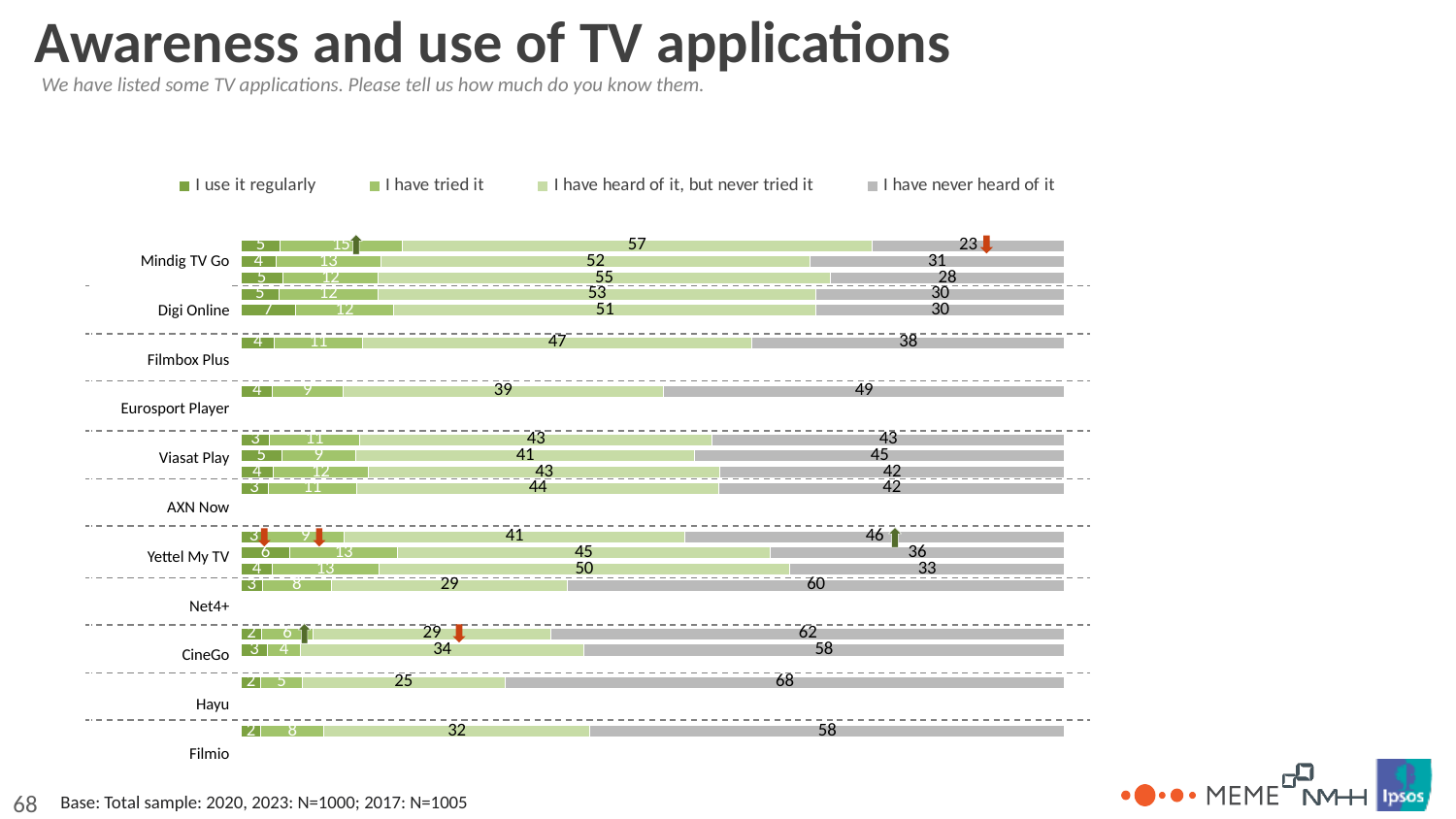
What is the value for 'I have never heard of it' for Hayu? 68 What kind of chart is shown on the slide? bar chart What is the value for 'I have heard of it, but never tried it' for Filmio? 32 What is the value for 'I have heard of it, but never tried it' for Filmbox Plus? 47 What is the value for 'I have never heard of it' for Eurosport Player? 49 Which has a larger 'I have never heard of it' value, Eurosport Player or Filmbox Plus? Eurosport Player What is the first entry in the chart's legend? I use it regularly Which TV application has the highest 'I have never heard of it' value on the chart? Hayu What is the difference between the 'I have never heard of it' values for Hayu and Filmio? 10 What is the total of the stacked bar for Hayu? 100 How many TV applications are listed as categories on the chart? 11 How many series does the legend list? 4